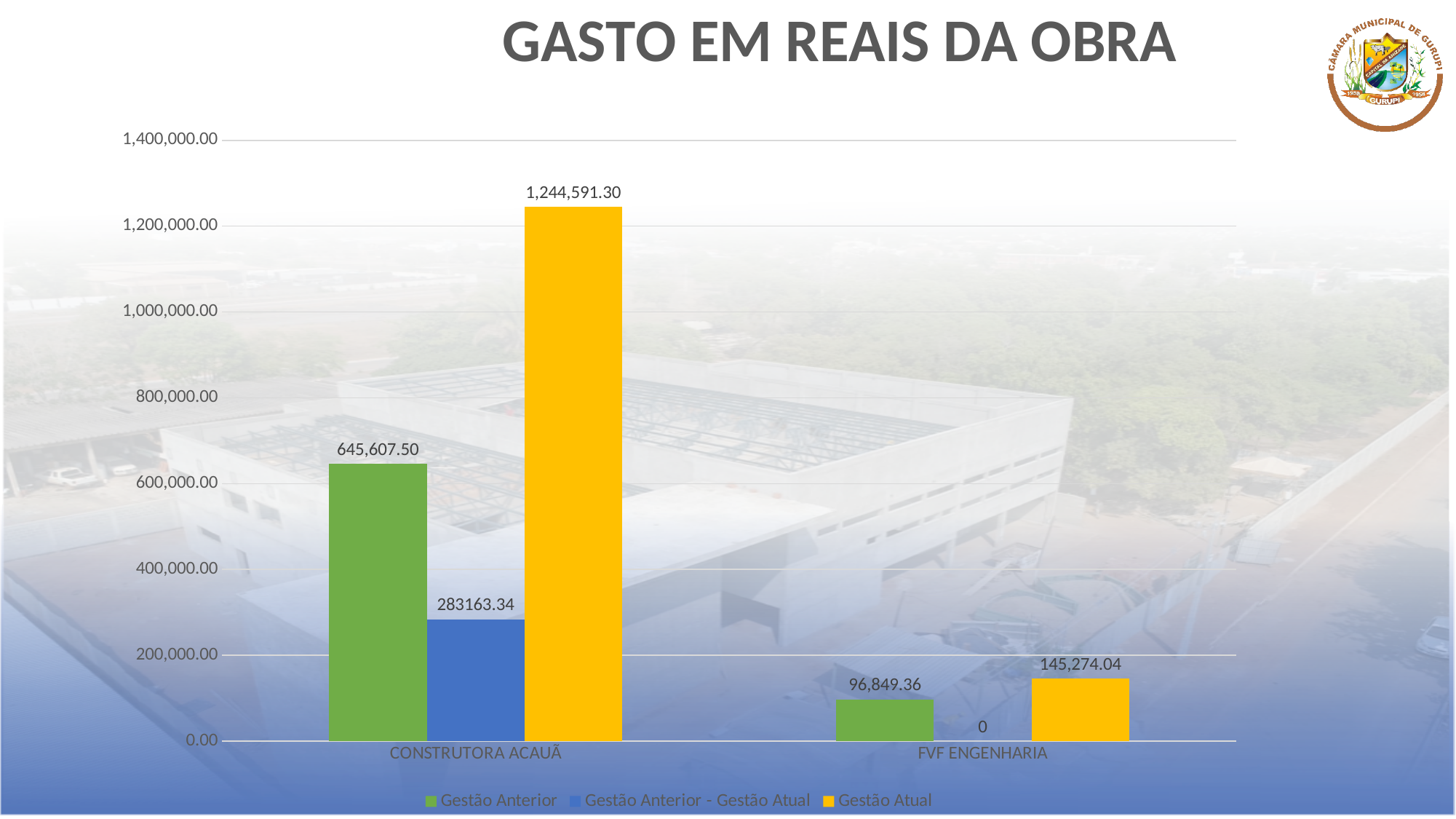
Is the Gestão Anterior value for FVF ENGENHARIA greater or less than 200,000.00? less What is the Gestão Anterior - Gestão Atual value for FVF ENGENHARIA? 0 What is the difference between the Gestão Atual and Gestão Anterior values for CONSTRUTORA ACAUÃ? 598,983.80 What is the Gestão Atual value for FVF ENGENHARIA? 145,274.04 Which series has the lowest value for FVF ENGENHARIA? Gestão Anterior - Gestão Atual What is the Gestão Anterior value for CONSTRUTORA ACAUÃ? 645,607.50 How many categories are shown on the x axis? 2 How many series does the legend list? 3 What type of chart is shown on the slide? Bar chart Which category has the highest Gestão Atual value? CONSTRUTORA ACAUÃ What is the Gestão Atual value for CONSTRUTORA ACAUÃ? 1,244,591.30 What is the title of the chart? GASTO EM REAIS DA OBRA